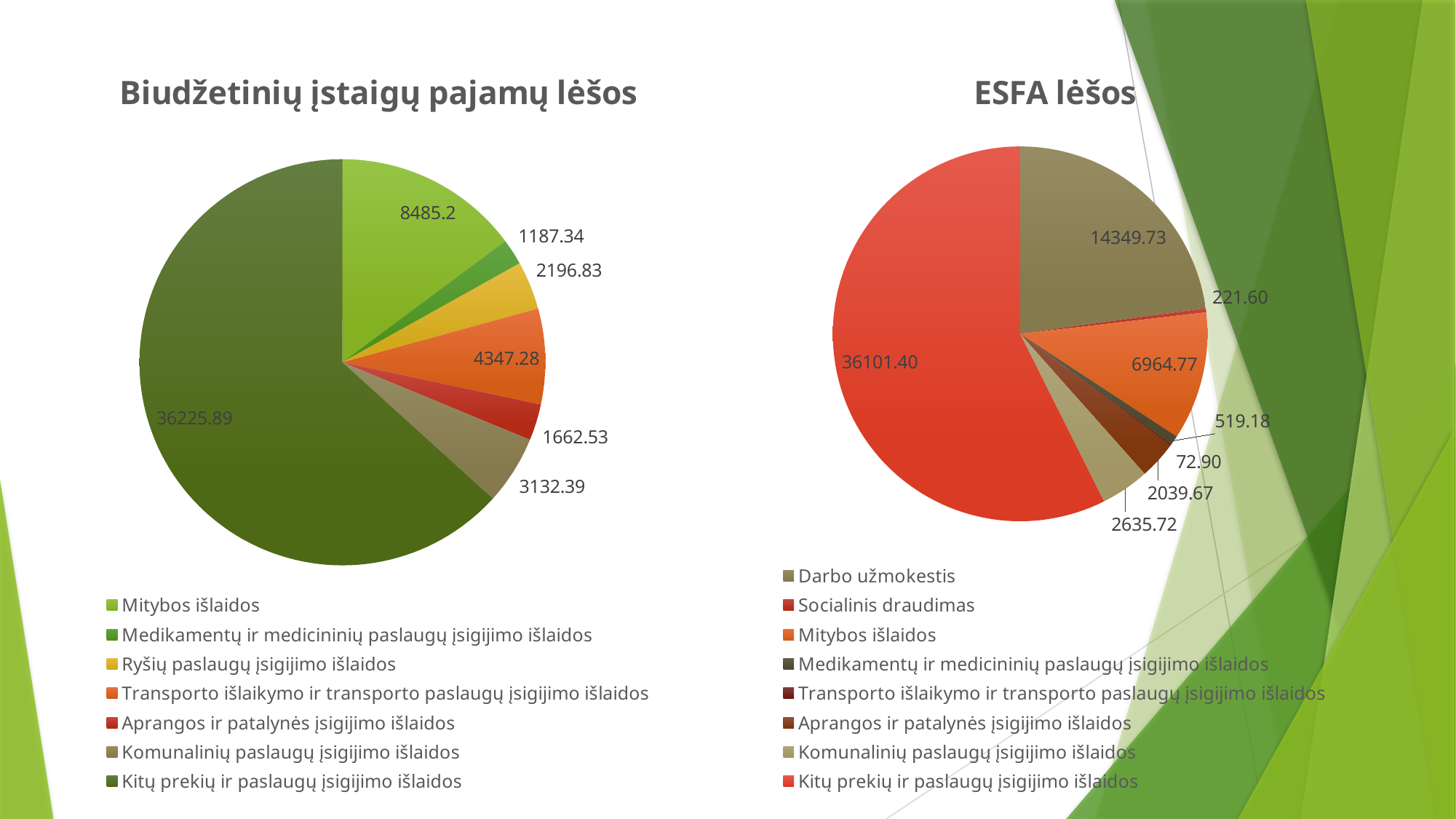
What type of chart is used for 'ESFA lėšos'? Pie chart In the 'Biudžetinių įstaigų pajamų lėšos' chart, which category has the largest slice? Kitų prekių ir paslaugų įsigijimo išlaidos In the 'ESFA lėšos' chart, what is the value for Darbo užmokestis? 14349.73 In the 'Biudžetinių įstaigų pajamų lėšos' chart, what is the value for Komunalinių paslaugų įsigijimo išlaidos? 3132.39 In the 'ESFA lėšos' chart, what is the difference between Darbo užmokestis and Mitybos išlaidos? 7384.96 In the 'Biudžetinių įstaigų pajamų lėšos' chart, what is the difference between Mitybos išlaidos and Transporto išlaikymo ir transporto paslaugų įsigijimo išlaidos? 4137.92 In the 'Biudžetinių įstaigų pajamų lėšos' chart, how many categories are shown? 7 In the 'ESFA lėšos' chart, what is the value for Transporto išlaikymo ir transporto paslaugų įsigijimo išlaidos? 72.90 In the 'ESFA lėšos' chart, which category has the smallest value? Transporto išlaikymo ir transporto paslaugų įsigijimo išlaidos In the 'ESFA lėšos' chart, which is larger: Aprangos ir patalynės įsigijimo išlaidos or Komunalinių paslaugų įsigijimo išlaidos? Komunalinių paslaugų įsigijimo išlaidos In the 'Biudžetinių įstaigų pajamų lėšos' chart, what is the value for Mitybos išlaidos? 8485.2 In the 'Biudžetinių įstaigų pajamų lėšos' chart, which category has the smallest slice? Medikamentų ir medicininių paslaugų įsigijimo išlaidos